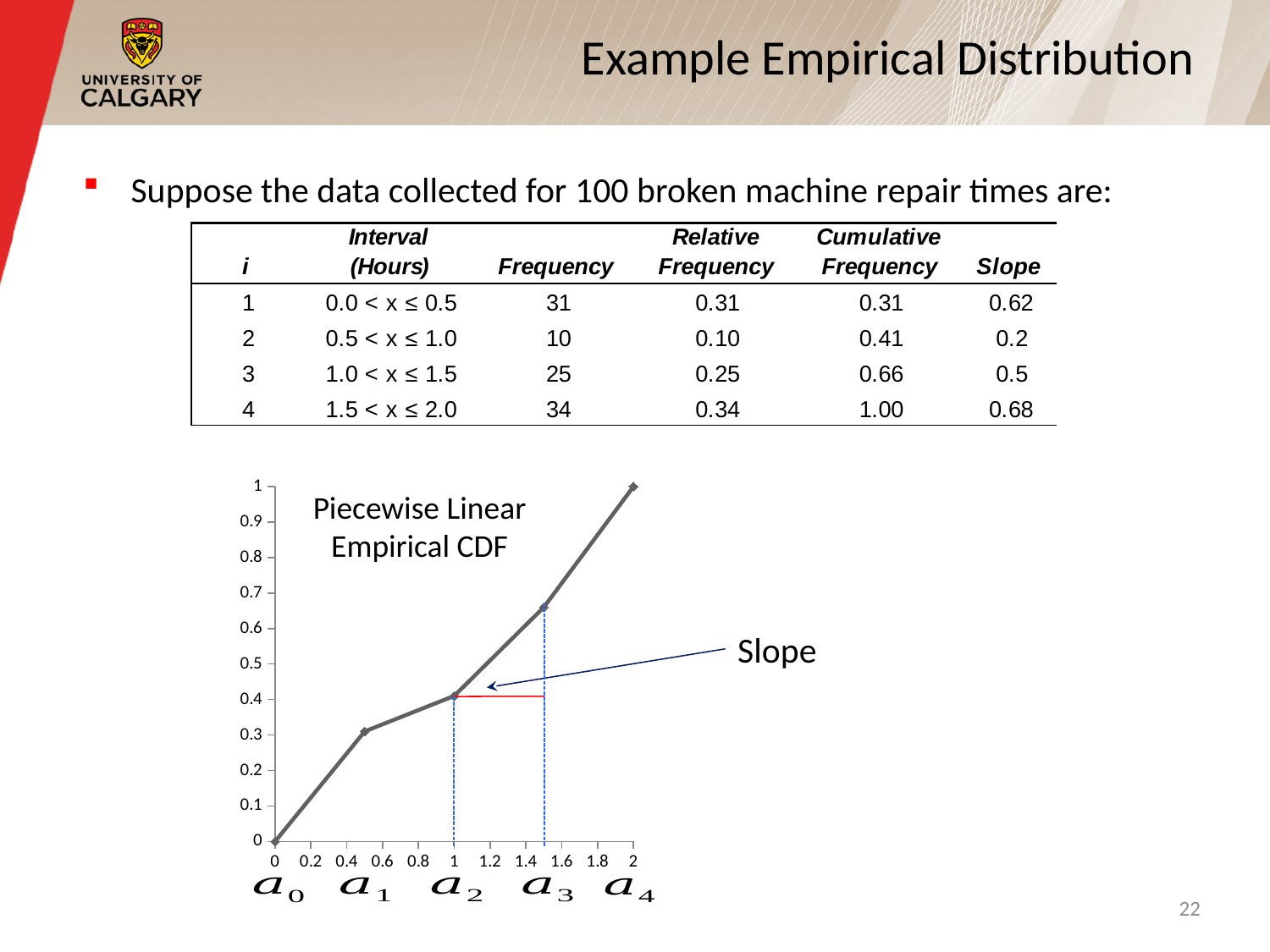
What is the value of the CDF at x = 0 on the chart? 0 What label does the arrow pointing to the line segment between a2 and a3 carry? Slope Is the value of the CDF at x = 1 greater or less than 0.5? less How many data points are plotted on the line chart? 5 Is the value of the CDF at x = 1.5 greater or less than 0.6? greater Is the value of the CDF at x = 0.5 greater or less than 0.4? less Which is larger, the CDF value at x = 1.5 or at x = 0.5? x = 1.5 Do the values on the chart rise or fall as x increases from 0 to 2? rise What is the value of the CDF at x = 2 on the chart? 1 What kind of chart is shown on the slide? line chart What title is written inside the chart area? Piecewise Linear Empirical CDF At which x value does the chart reach its highest point? 2